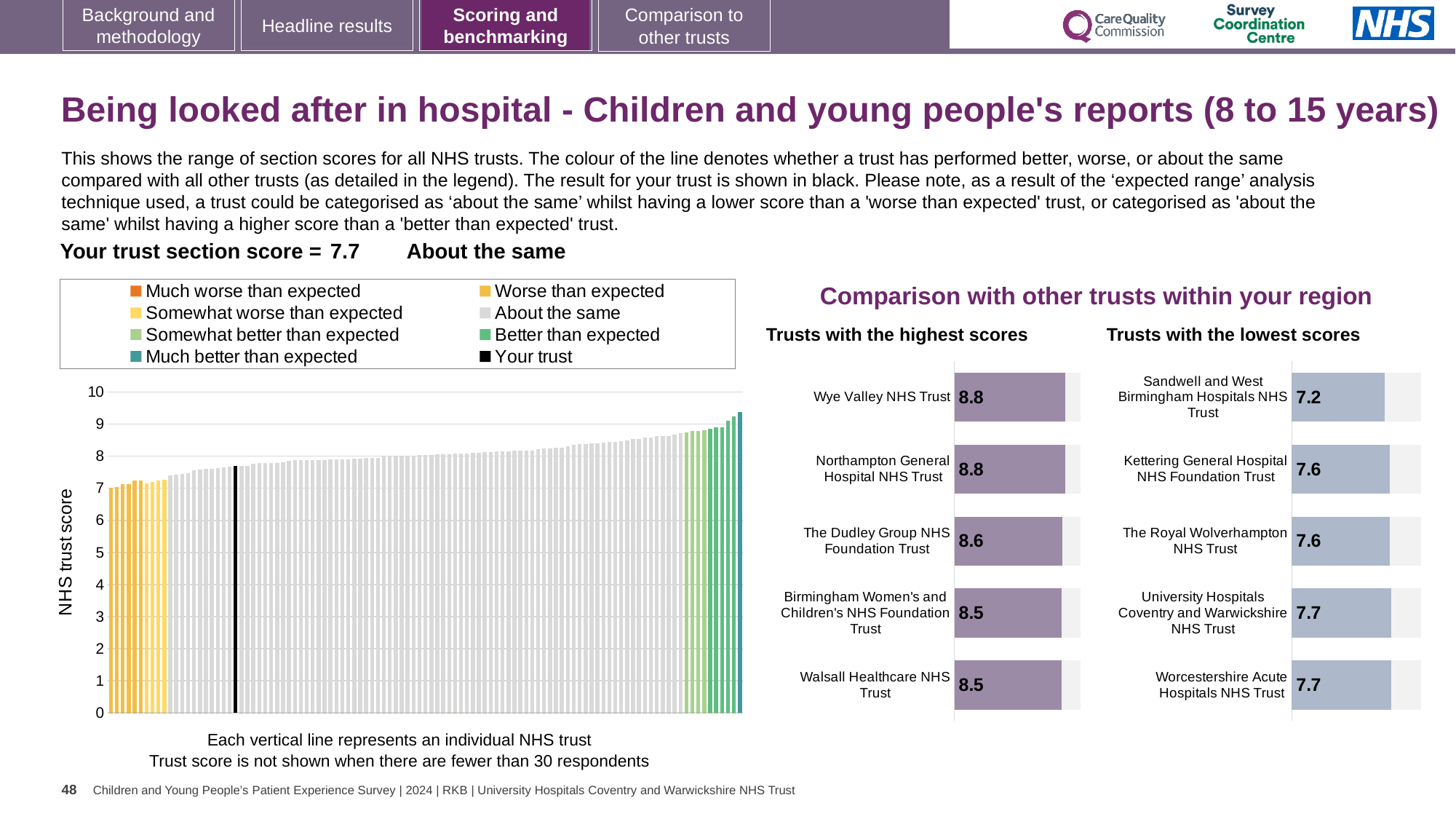
In the 'Trusts with the lowest scores' chart, which trust has the lowest score? Sandwell and West Birmingham Hospitals NHS Trust In the 'Trusts with the highest scores' chart, how many trusts are shown? 5 In the 'Trusts with the highest scores' chart, what is the score for Walsall Healthcare NHS Trust? 8.5 How many entries does the legend above the large chart on the left list? 8 In the large chart on the left, is the value of the shortest bar greater or less than 6? greater In the 'Trusts with the highest scores' chart, what is the score for The Dudley Group NHS Foundation Trust? 8.6 In the 'Trusts with the lowest scores' chart, what is the score for Kettering General Hospital NHS Foundation Trust? 7.6 In the 'Trusts with the highest scores' chart, what is the difference between the scores of Wye Valley NHS Trust and Walsall Healthcare NHS Trust? 0.3 In the large chart on the left, is the value of the tallest bar greater or less than 9? greater In the 'Trusts with the lowest scores' chart, what is the difference between the scores of University Hospitals Coventry and Warwickshire NHS Trust and Sandwell and West Birmingham Hospitals NHS Trust? 0.5 What kind of chart is the large chart on the left showing NHS trust scores? bar chart In the large chart on the left, what is the label on the vertical axis? NHS trust score